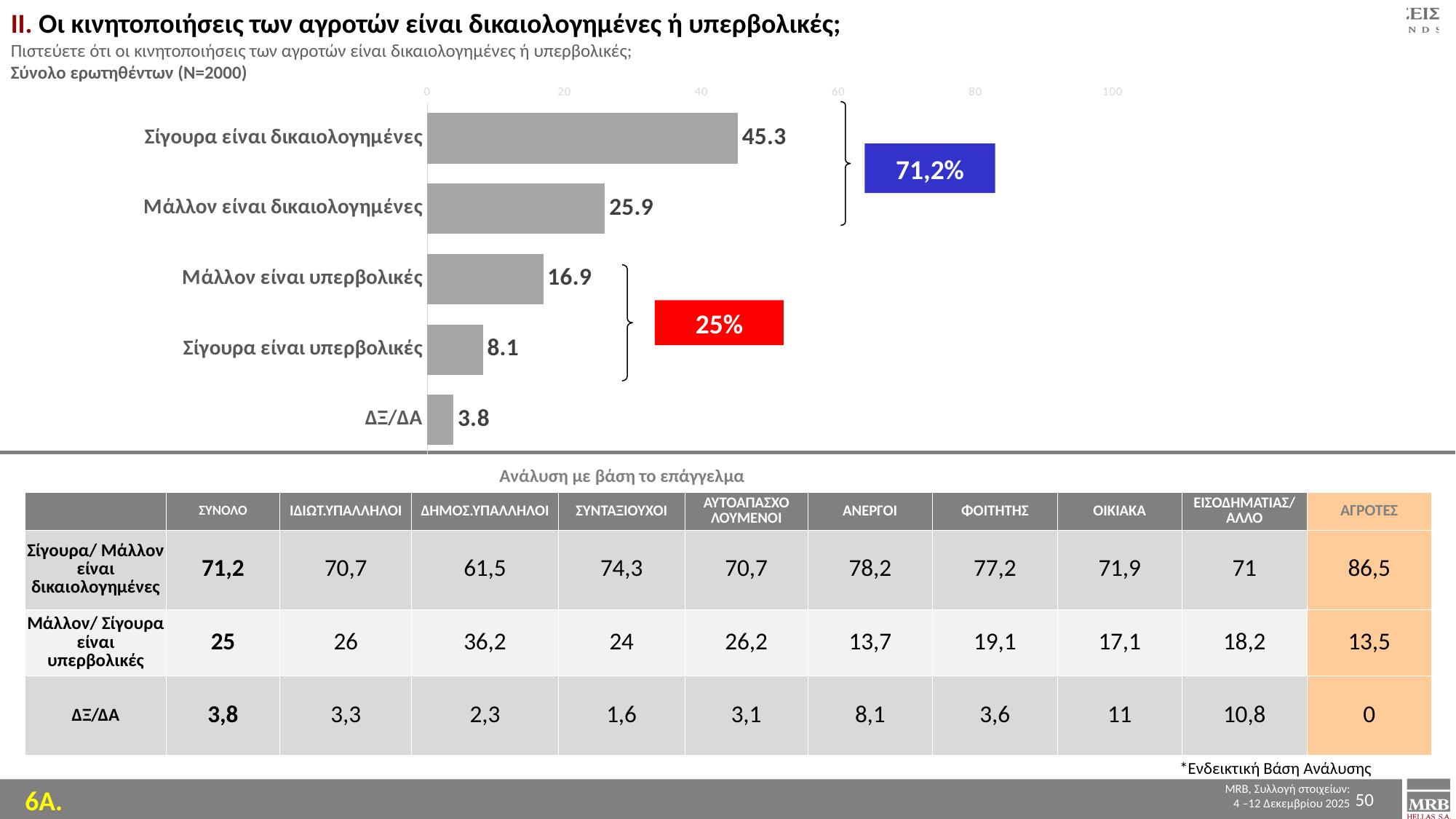
Which category has the lowest value in the bar chart? ΔΞ/ΔΑ What value is shown for "Μάλλον είναι υπερβολικές"? 16.9 Is the value for "Μάλλον είναι δικαιολογημένες" greater or less than 20? greater Which is larger: the value for "Μάλλον είναι υπερβολικές" or "Σίγουρα είναι υπερβολικές"? Μάλλον είναι υπερβολικές What is the difference between the values for "Σίγουρα είναι δικαιολογημένες" and "Μάλλον είναι δικαιολογημένες"? 19.4 What percentage is shown in the blue callout box next to the two "δικαιολογημένες" bars? 71,2% What kind of chart is shown on the slide? bar chart What value is shown for "Σίγουρα είναι δικαιολογημένες"? 45.3 What value is shown for "ΔΞ/ΔΑ"? 3.8 What percentage is shown in the red callout box next to the two "υπερβολικές" bars? 25% How many categories are plotted in the bar chart? 5 Which category has the highest value in the bar chart? Σίγουρα είναι δικαιολογημένες